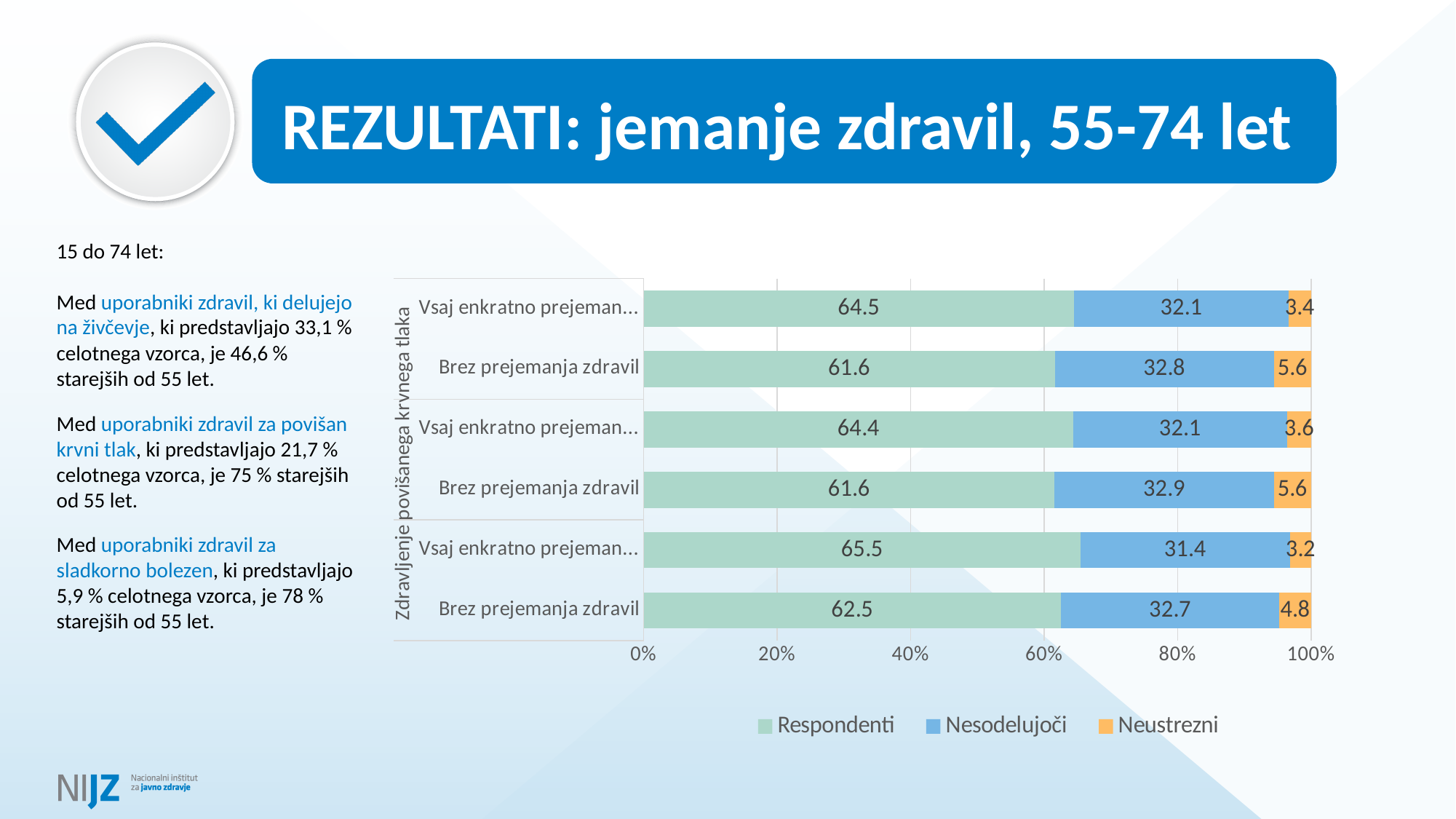
What is the Neustrezni value for the bottom bar (Brez prejemanja zdravil)? 4.8 How many series does the chart legend list? 3 Which is larger: the Neustrezni value of the second bar from the top or the Neustrezni value of the top bar? the second bar from the top (5.6) What is the Nesodelujoči value for the fifth bar from the top (Vsaj enkratno prejeman...)? 31.4 What kind of chart is shown on the slide? stacked bar chart Which series is shown in orange in the chart? Neustrezni Which bar has the highest Respondenti value? the fifth bar from the top (Vsaj enkratno prejeman...), 65.5 How many bars are plotted in the chart? 6 What is the Respondenti value for the topmost bar (Vsaj enkratno prejeman...)? 64.5 Which bar has the lowest Neustrezni value? the fifth bar from the top (Vsaj enkratno prejeman...), 3.2 What is the difference between the Respondenti values of the top bar (64.5) and the second bar from the top (61.6)? 2.9 What is the total of the three segments in the topmost bar? 100.0